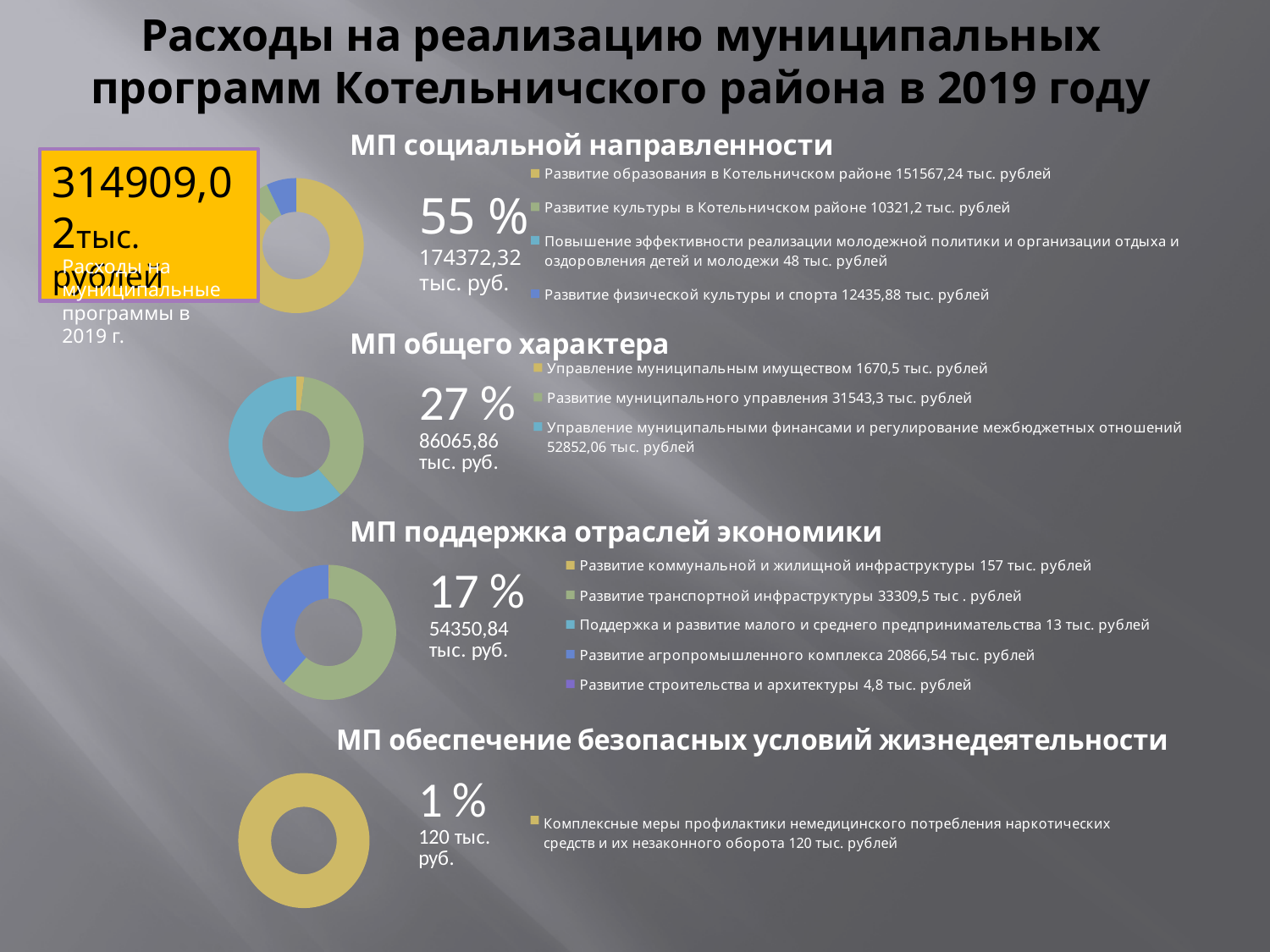
What percentage is shown next to the 'МП обеспечение безопасных условий жизнедеятельности' chart? 1 % What kind of chart is used in the 'МП социальной направленности' section? doughnut (pie) chart In the 'МП поддержка отраслей экономики' chart, what is the value for 'Развитие строительства и архитектуры'? 4,8 тыс. рублей In the 'МП социальной направленности' chart, what is the value for 'Развитие образования в Котельничском районе'? 151567,24 тыс. рублей In the 'МП социальной направленности' chart, which category has the lowest value? Повышение эффективности реализации молодежной политики и организации отдыха и оздоровления детей и молодежи In the 'МП общего характера' chart, what is the difference between 'Развитие муниципального управления' and 'Управление муниципальным имуществом'? 29872,8 тыс. рублей In the 'МП социальной направленности' chart, how many entries does the legend list? 4 In the 'МП поддержка отраслей экономики' chart, how many categories are listed in the legend? 5 In the 'МП общего характера' chart, which category has the highest value? Управление муниципальными финансами и регулирование межбюджетных отношений In the 'МП поддержка отраслей экономики' chart, which is larger: 'Развитие транспортной инфраструктуры' or 'Развитие агропромышленного комплекса'? Развитие транспортной инфраструктуры What percentage is shown next to the 'МП общего характера' chart? 27 % What total is shown next to the 'МП социальной направленности' chart? 174372,32 тыс. руб.